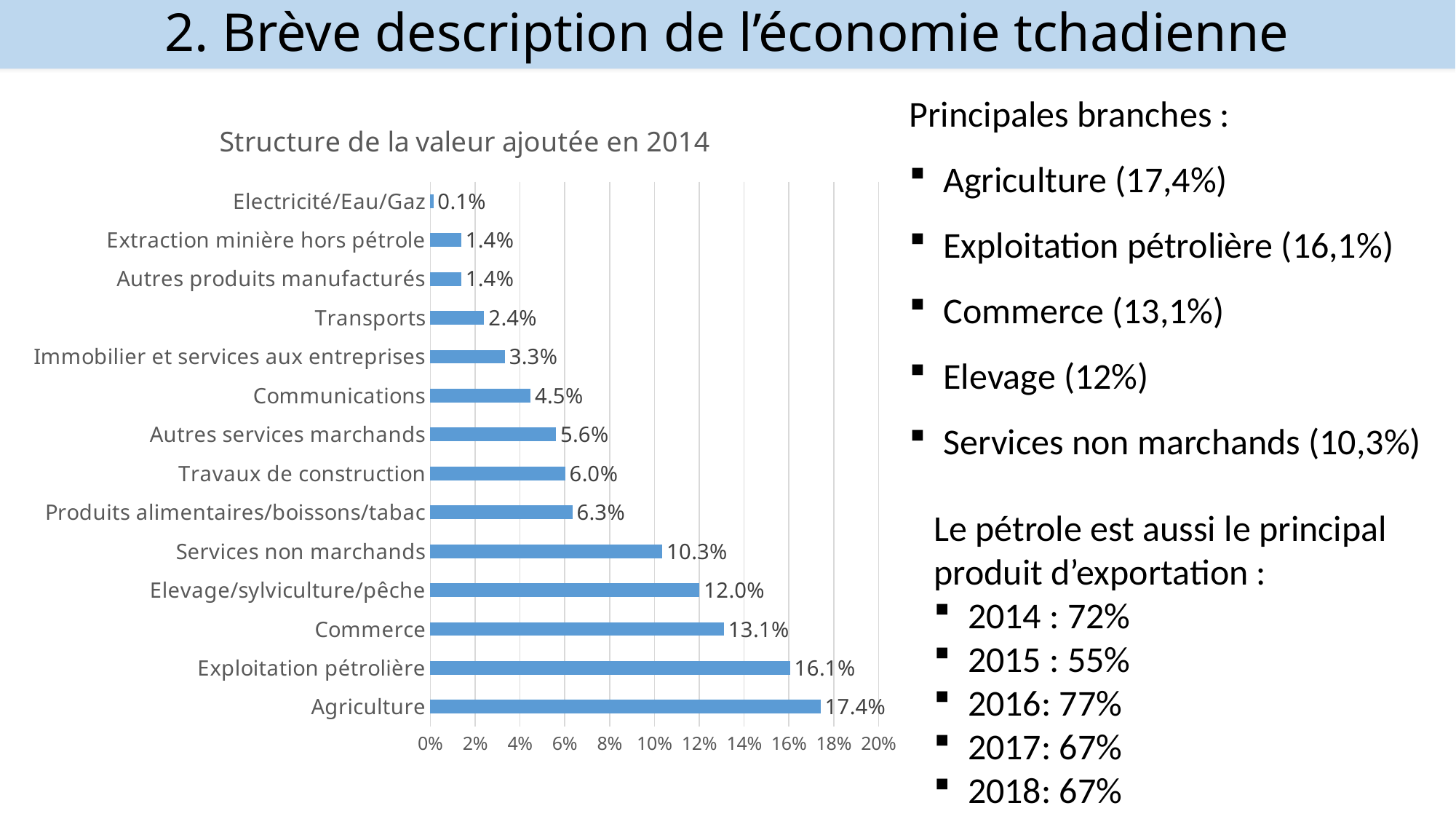
Which category has the highest value in the chart? Agriculture What is the value for Agriculture in the chart? 17.4% What is the value for Commerce in the chart? 13.1% Which category has the lowest value in the chart? Electricité/Eau/Gaz What kind of chart is shown on the slide? Bar chart What is the difference between the values for Agriculture and Exploitation pétrolière? 1.3% Is the value for Exploitation pétrolière greater or less than 14%? greater What is the difference between the values for Services non marchands and Travaux de construction? 4.3% What is the value for Communications in the chart? 4.5% How many categories are shown in the chart? 14 What is the title of the chart? Structure de la valeur ajoutée en 2014 Which is larger, the value for Elevage/sylviculture/pêche or the value for Commerce? Commerce